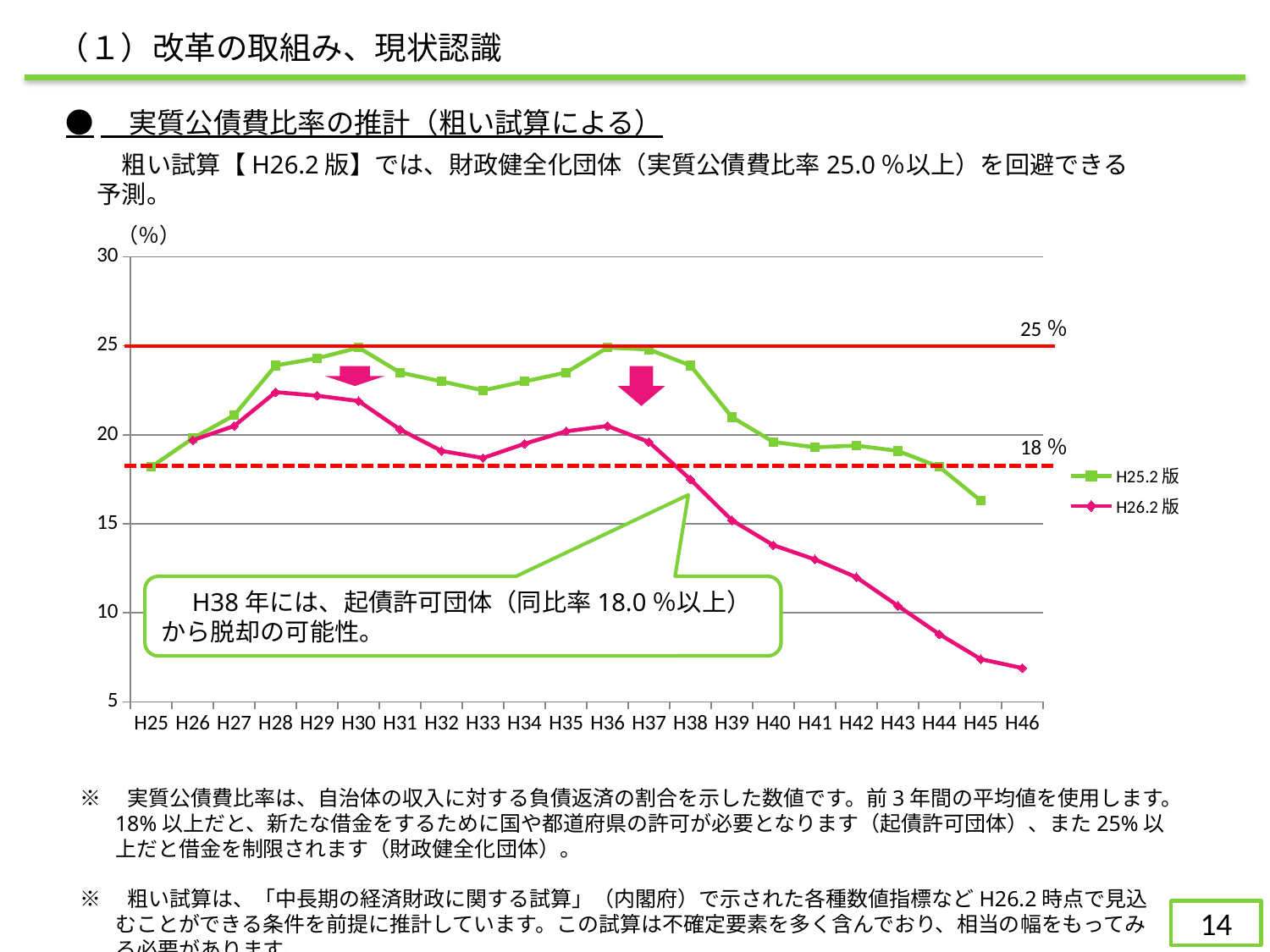
What kind of chart is shown on the slide? line chart Is the value for H26.2版 at H42 greater or less than 10? greater Does the H26.2版 series rise or fall from H36 to H46? fall Is the value for H25.2版 at H45 greater or less than 15? greater Is the value for H26.2版 at H46 greater or less than 10? less What are the two series named in the legend? H25.2版 and H26.2版 At which year is the H26.2版 series lowest? H46 How many series does the legend list? 2 How many years (categories) are shown on the x axis? 22 At which year is the H25.2版 series lowest? H45 At H40, which series has the larger value, H25.2版 or H26.2版? H25.2版